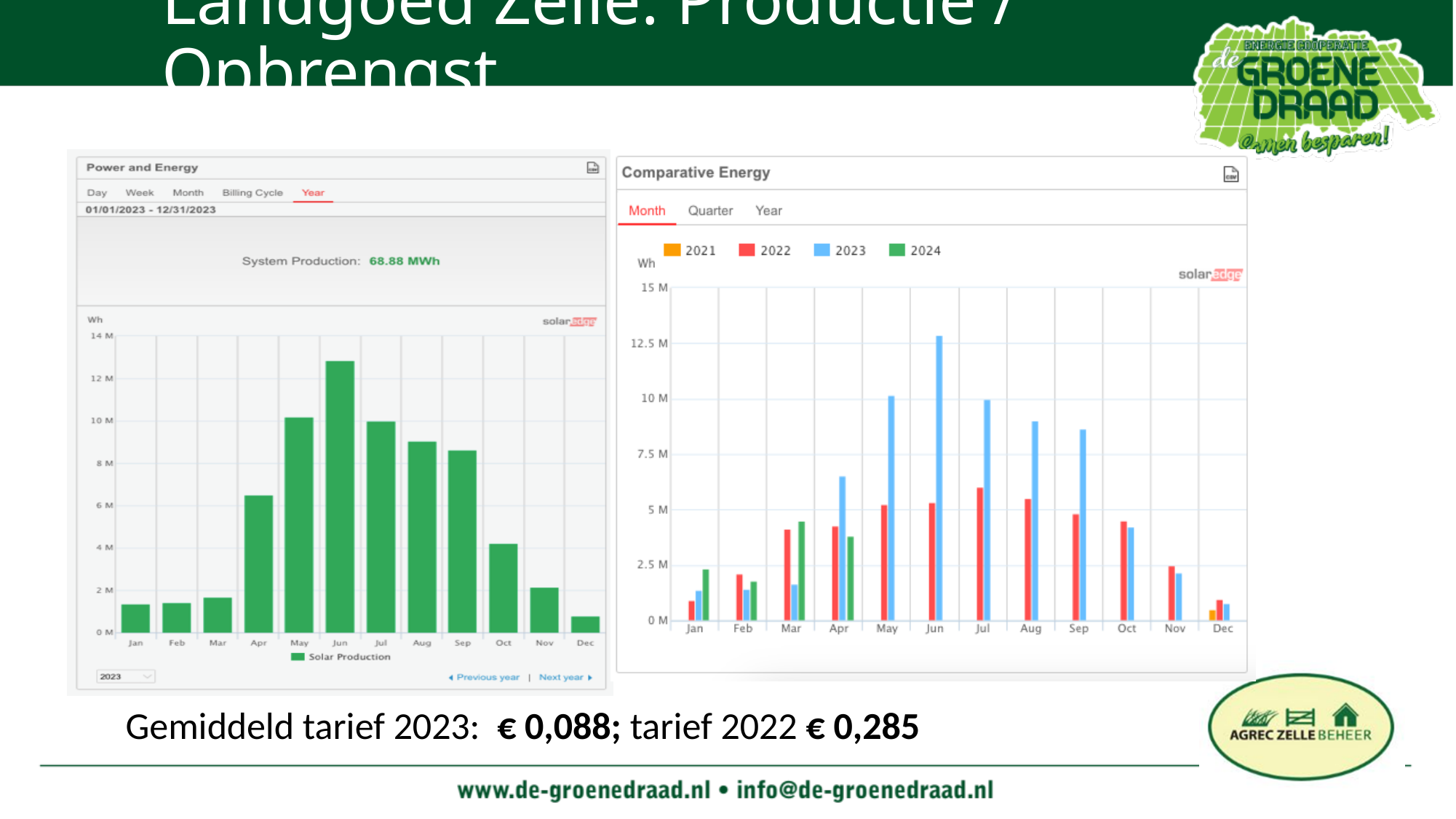
On the Comparative Energy chart, which month has the highest 2023 value? Jun On the Comparative Energy chart, is the 2023 value for Jun greater or less than 10 M? greater On the Power and Energy chart, which month has the lowest solar production? Dec On the Power and Energy chart, is the value for Dec greater or less than 2 M? less How many series does the legend of the Comparative Energy chart list? 4 On the Power and Energy chart, which is larger, the value for Apr or the value for Oct? Apr What is the System Production value shown on the Power and Energy chart? 68.88 MWh What kind of chart is the Comparative Energy chart? bar chart On the Power and Energy chart, which month has the highest solar production? Jun On the Comparative Energy chart, which is larger, the 2022 value for Mar or the 2023 value for Mar? 2022 On the Power and Energy chart, do the values rise or fall from Jun to Dec? fall On the Power and Energy chart, is the value for Jun greater or less than 12 M? greater